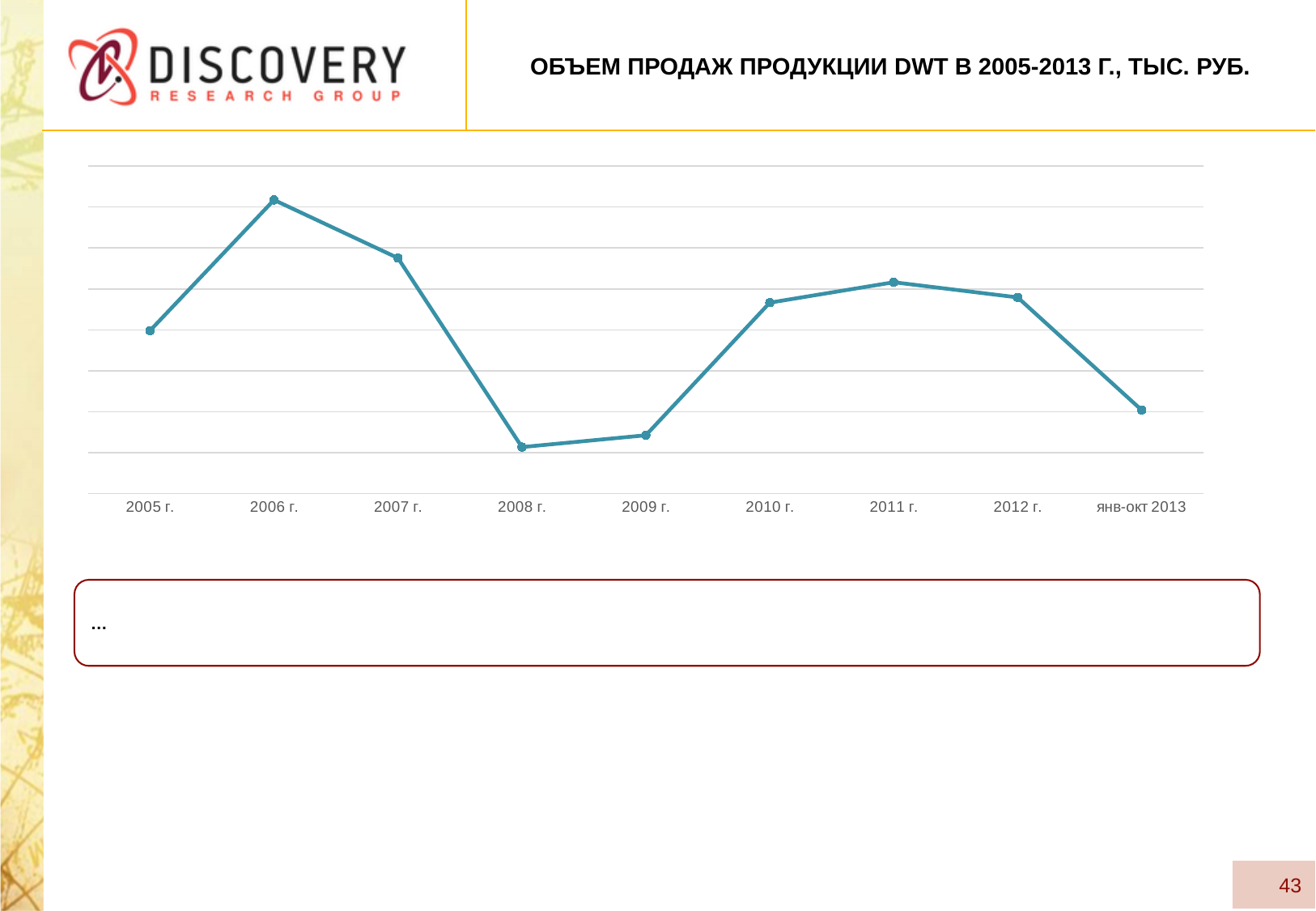
Which is higher, the value for 2007 г. or the value for 2011 г.? 2007 г. Which period has the highest sales volume on the chart? 2006 г. How many data points are plotted on the line chart? 9 Which is higher, the value for 2006 г. or the value for 2007 г.? 2006 г. What kind of chart is shown on the slide? line chart What is the title of the chart on the slide? ОБЪЕМ ПРОДАЖ ПРОДУКЦИИ DWT В 2005-2013 Г., ТЫС. РУБ. Do the values rise or fall from 2006 г. to 2008 г.? fall Do the values rise or fall from 2008 г. to 2011 г.? rise Which is higher, the value for 2005 г. or the value for 2010 г.? 2010 г. Do the values rise or fall from 2011 г. to янв-окт 2013? fall Which period has the lowest sales volume on the chart? 2008 г.